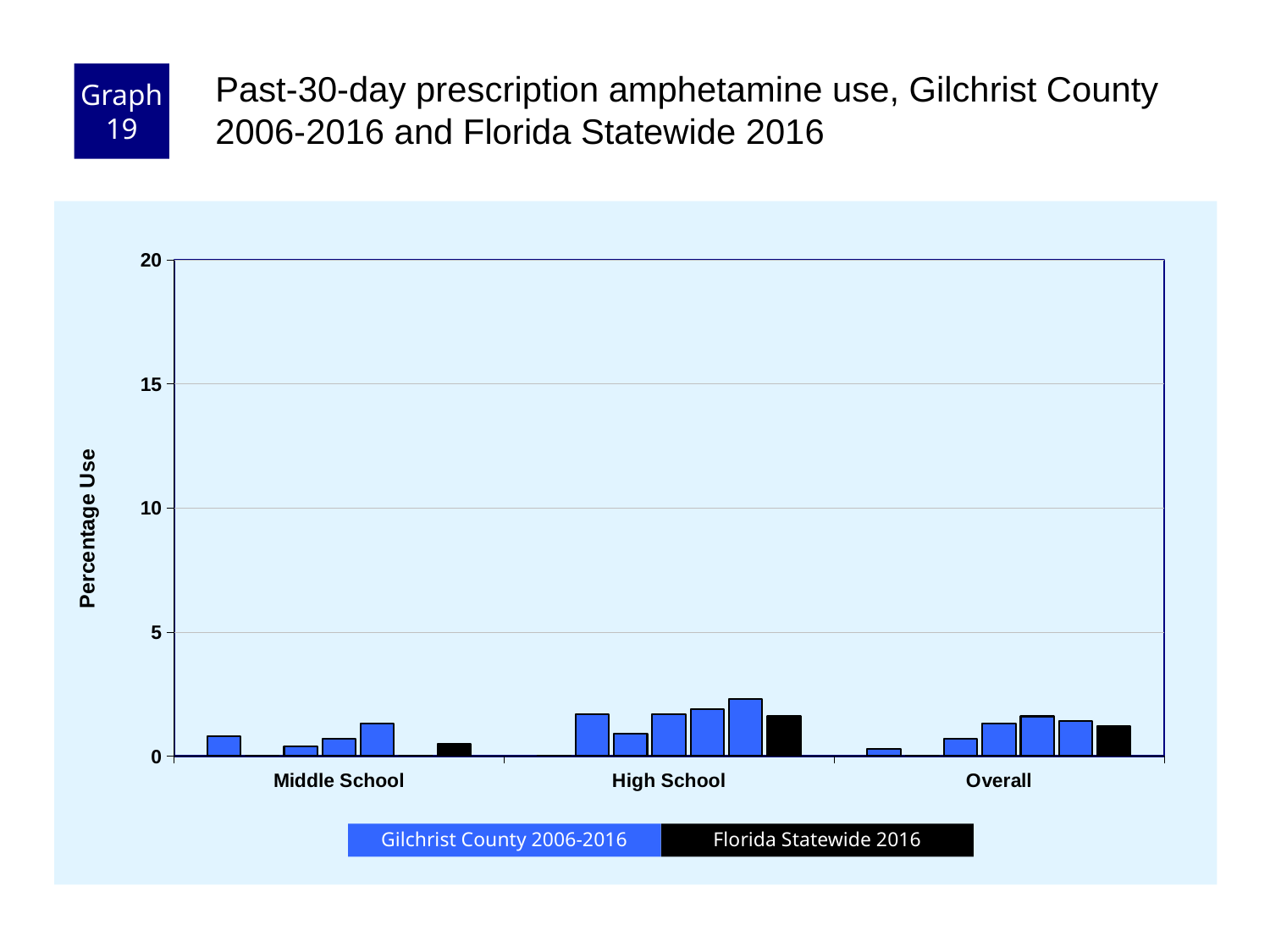
How many categories are shown on the x axis? 3 Which category has the lowest bars overall? Middle School What is the label on the y axis? Percentage Use How many series does the legend list? 2 Are all the plotted values greater or less than 10? less Is the Florida Statewide 2016 value for High School greater or less than 5? less What kind of chart is shown on the slide? bar chart Is the Florida Statewide 2016 value for Middle School greater or less than 5? less Is the Florida Statewide 2016 value for High School larger or smaller than the Florida Statewide 2016 value for Middle School? larger Which category has the highest bars overall? High School Which series is shown in black in the legend? Florida Statewide 2016